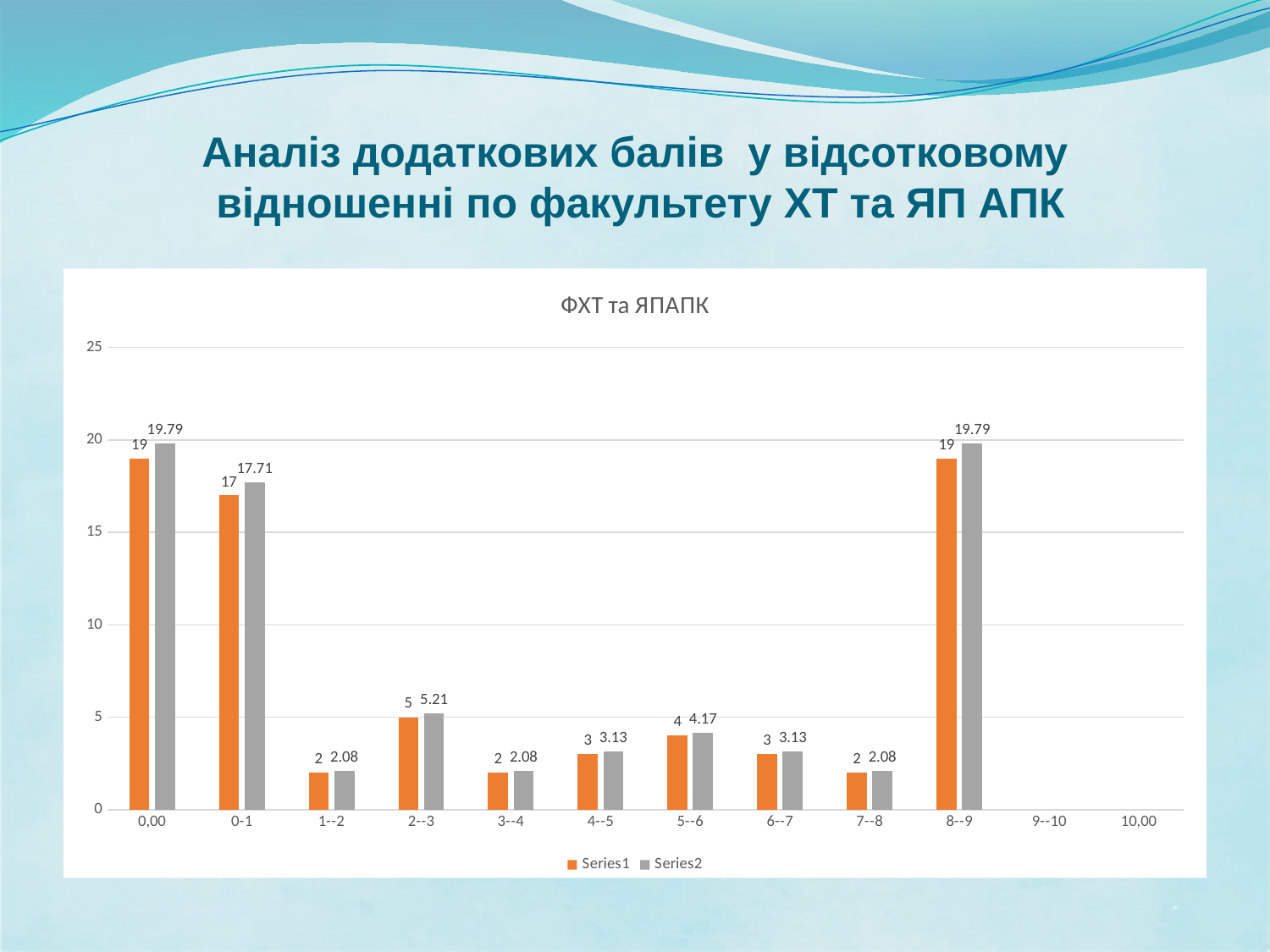
What is the Series2 value for the 0-1 category? 17.71 What is the difference between the Series1 values for 0,00 and 0-1? 2 What is the Series1 value for the 0-1 category? 17 Which category has the larger Series1 value, 5--6 or 6--7? 5--6 What is the Series1 value for the 2--3 category? 5 What is the difference between the Series2 values for 2--3 and 1--2? 3.13 What is the Series2 value for the 5--6 category? 4.17 How many series does the legend list? 2 What type of chart is shown on the slide? bar chart Is the Series2 value for 0-1 greater or less than 15? greater How many categories are shown on the x axis? 12 What is the Series2 value for the 8--9 category? 19.79